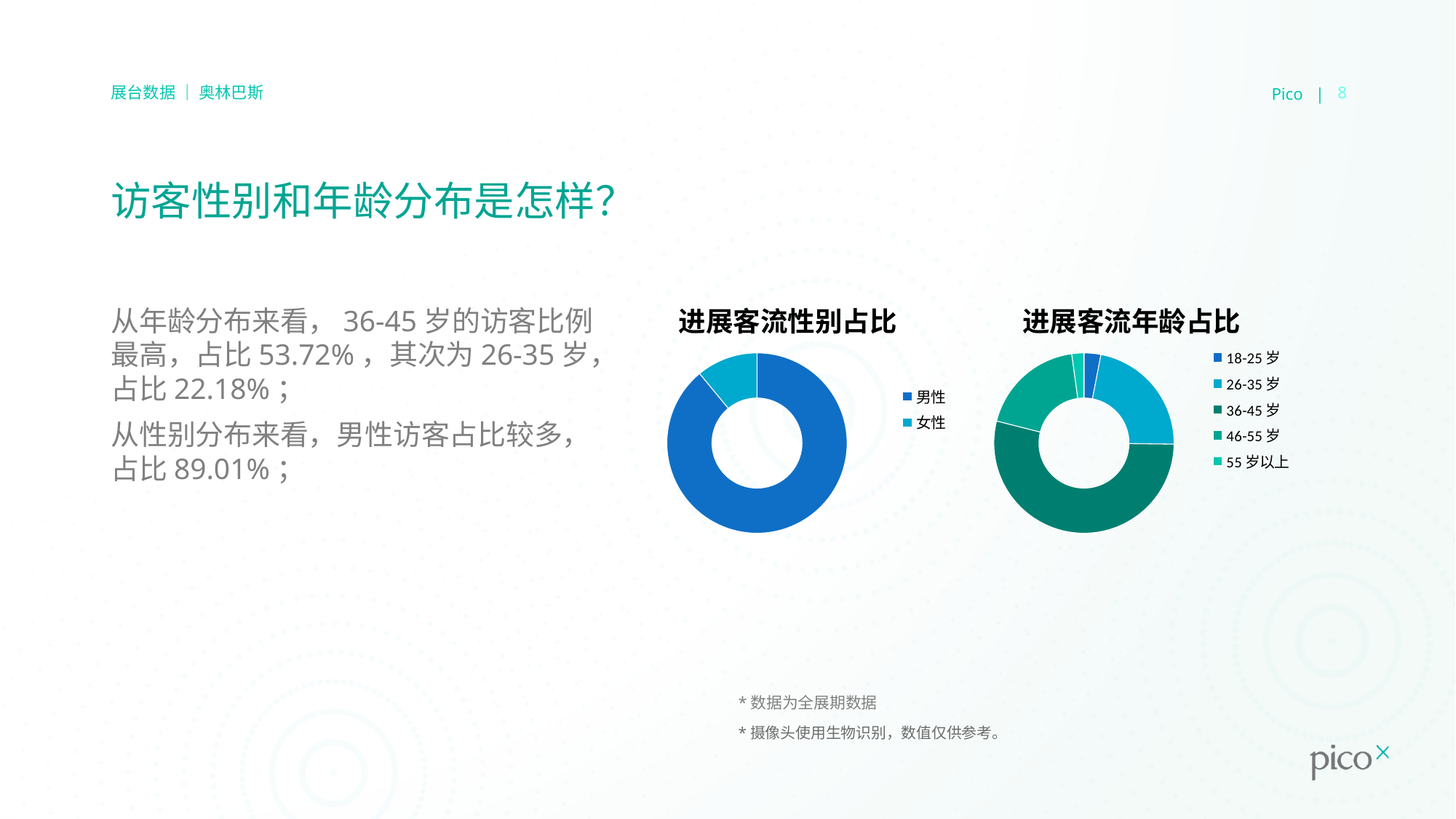
In the 进展客流年龄占比 chart, which slice is larger, 26-35 岁 or 46-55 岁? 26-35 岁 According to the slide, what share of visitors in the 进展客流性别占比 chart are 男性? 89.01% According to the slide, what share of visitors in the 进展客流年龄占比 chart are 36-45 岁? 53.72% Using the values stated on the slide, how much larger is the 36-45 岁 share than the 26-35 岁 share in the 进展客流年龄占比 chart? 31.54% What is the title of the chart on the right side of the slide? 进展客流年龄占比 According to the slide, what share of visitors in the 进展客流年龄占比 chart are 26-35 岁? 22.18% In the 进展客流性别占比 chart, which category has the largest share? 男性 How many age groups does the legend of the 进展客流年龄占比 chart list? 5 What kind of chart is the 进展客流性别占比 chart? doughnut chart In the 进展客流年龄占比 chart, which age group has the largest share? 36-45 岁 How many categories does the legend of the 进展客流性别占比 chart list? 2 In the 进展客流性别占比 chart, which slice is larger, 男性 or 女性? 男性